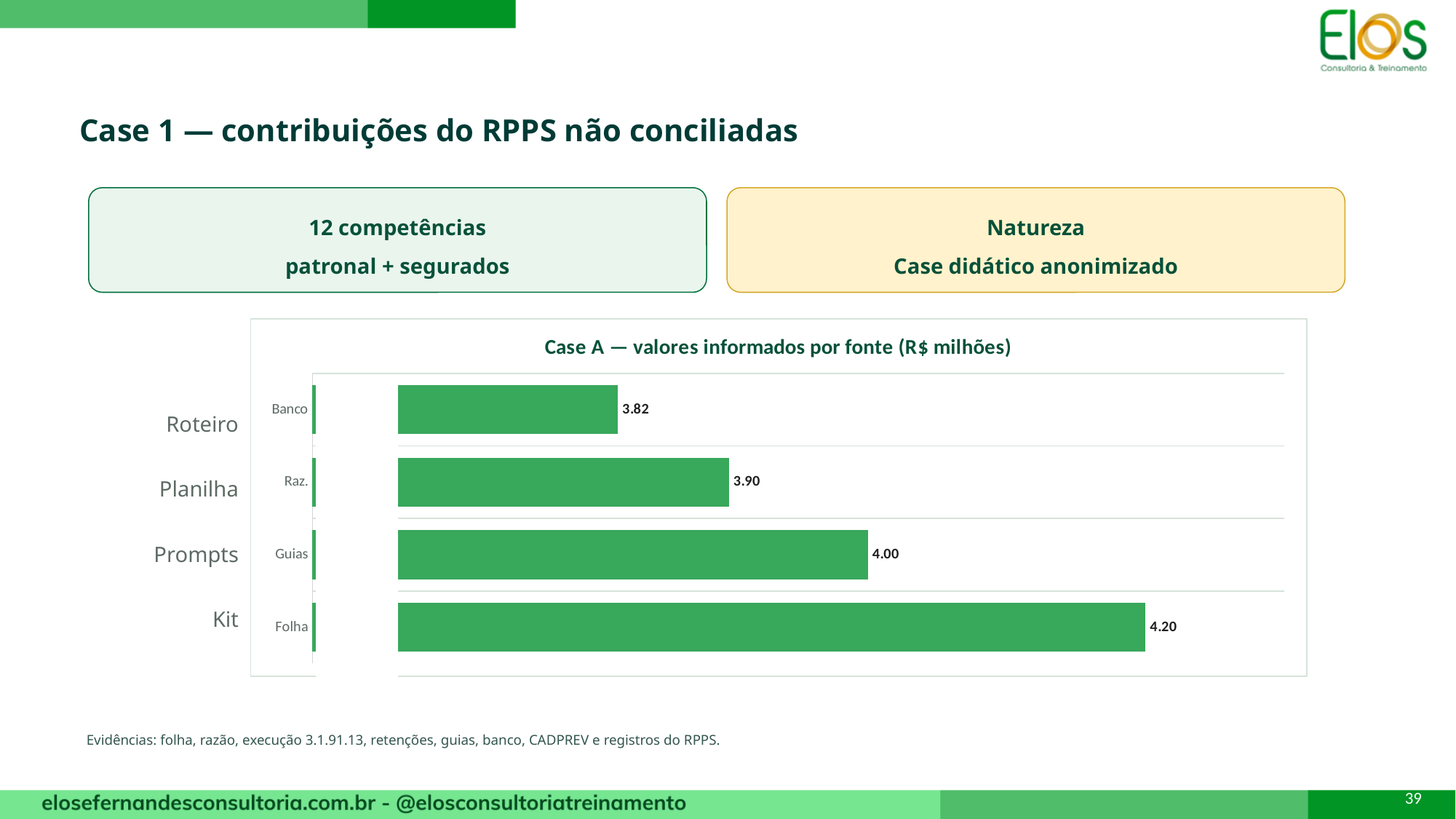
What is the difference between the values for Guias and Raz.? 0.10 What is the value for Raz. in the chart? 3.90 What is the value for Guias in the chart? 4.00 Which is larger, the value for Guias or the value for Banco? Guias What is the difference between the values for Folha and Banco? 0.38 Which source has the lowest value in the chart? Banco What kind of chart is shown on the slide? Bar chart What is the title of the chart? Case A — valores informados por fonte (R$ milhões) How many sources (bars) are shown in the chart? 4 What is the value for Folha in the chart? 4.20 Which source has the highest value in the chart? Folha What is the value for Banco in the chart? 3.82